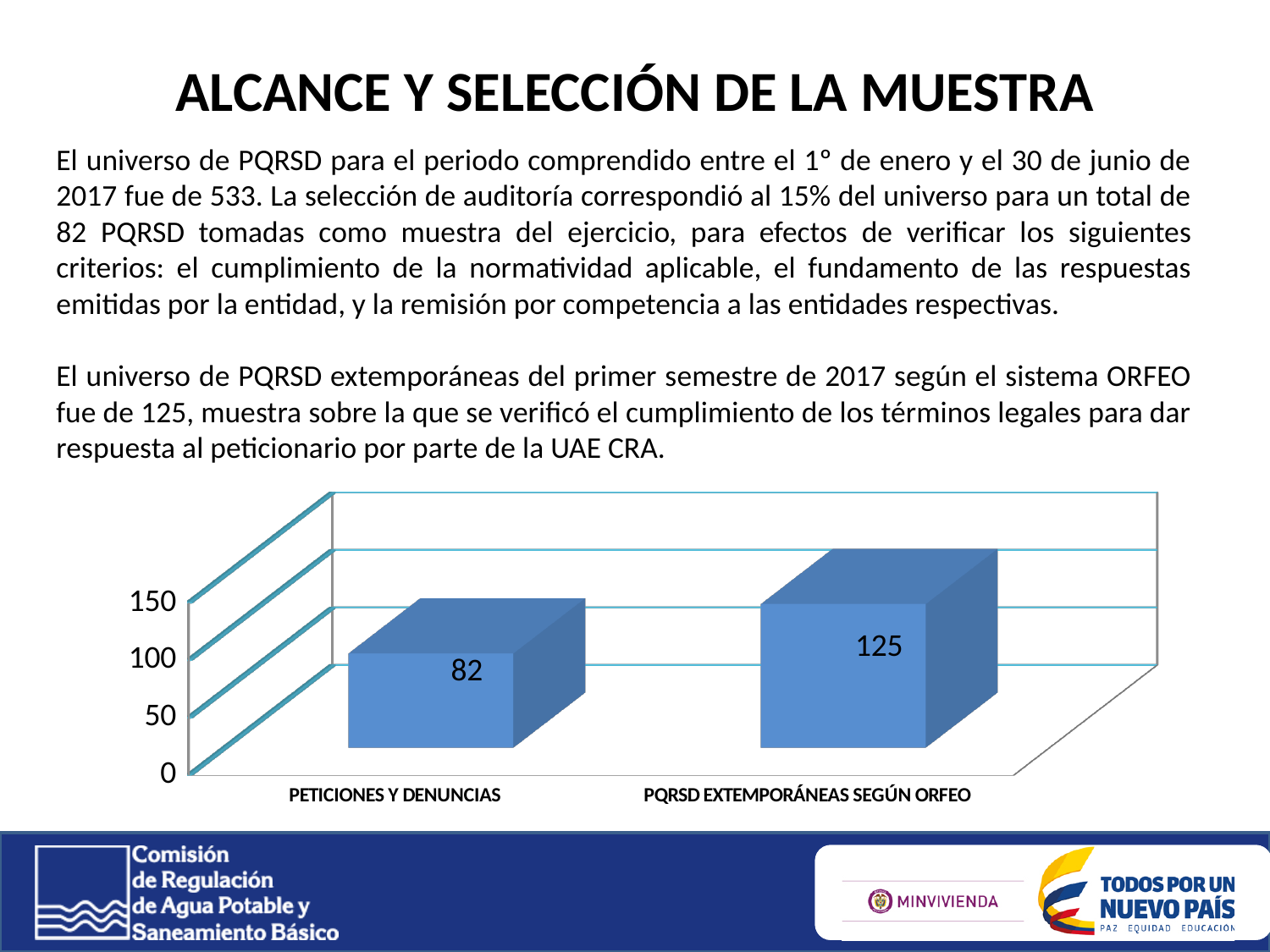
Which category has the highest value? PQRSD EXTEMPORÁNEAS SEGÚN ORFEO What is the difference between the values for PQRSD EXTEMPORÁNEAS SEGÚN ORFEO and PETICIONES Y DENUNCIAS? 43 What is the value for PQRSD EXTEMPORÁNEAS SEGÚN ORFEO? 125 How many categories are shown in the chart? 2 Is the value for PETICIONES Y DENUNCIAS greater or less than 100? less What is the value for PETICIONES Y DENUNCIAS? 82 What kind of chart is shown on the slide? bar chart What is the total of the two values shown in the chart? 207 Is the value for PQRSD EXTEMPORÁNEAS SEGÚN ORFEO greater or less than 100? greater Which category has the lowest value? PETICIONES Y DENUNCIAS Which is larger, the value for PETICIONES Y DENUNCIAS or the value for PQRSD EXTEMPORÁNEAS SEGÚN ORFEO? PQRSD EXTEMPORÁNEAS SEGÚN ORFEO What is the highest value labelled on the vertical axis of the chart? 150